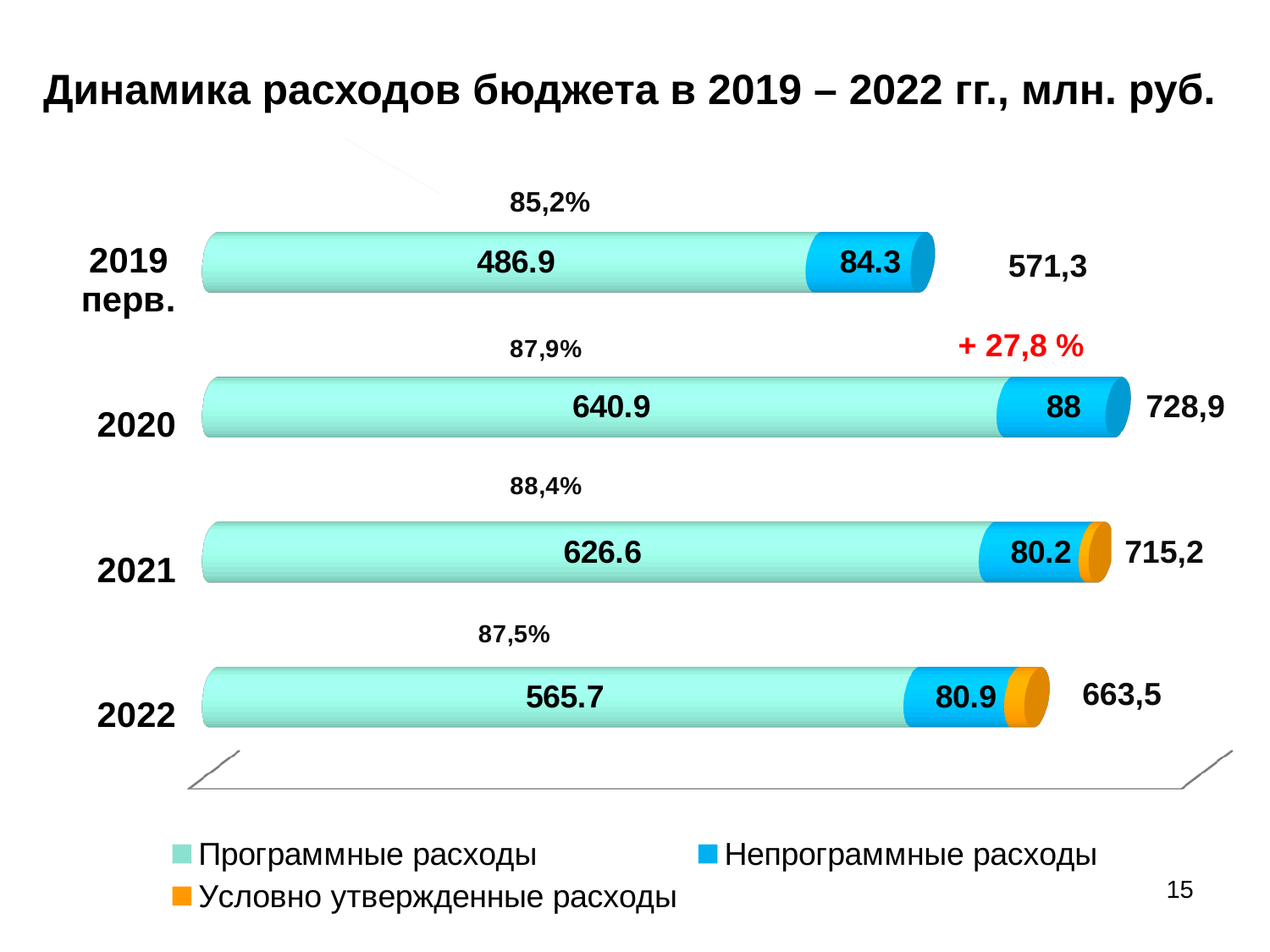
What total is printed next to the bar for 2021? 715,2 What is the title of the chart? Динамика расходов бюджета в 2019 – 2022 гг., млн. руб. How many years (categories) are shown in the chart? 4 Which year has the highest value of Программные расходы? 2020 What is the value of Непрограммные расходы for 2019 перв.? 84.3 How many series does the legend list? 3 Which year has the lowest value of Программные расходы? 2019 перв. What is the difference between Программные расходы in 2020 and in 2021? 14.3 What percentage is shown above the bar for 2022? 87,5% What is the value of Программные расходы for 2020? 640.9 Which is larger: Непрограммные расходы in 2020 or in 2022? 2020 What kind of chart is shown on the slide? Stacked bar chart